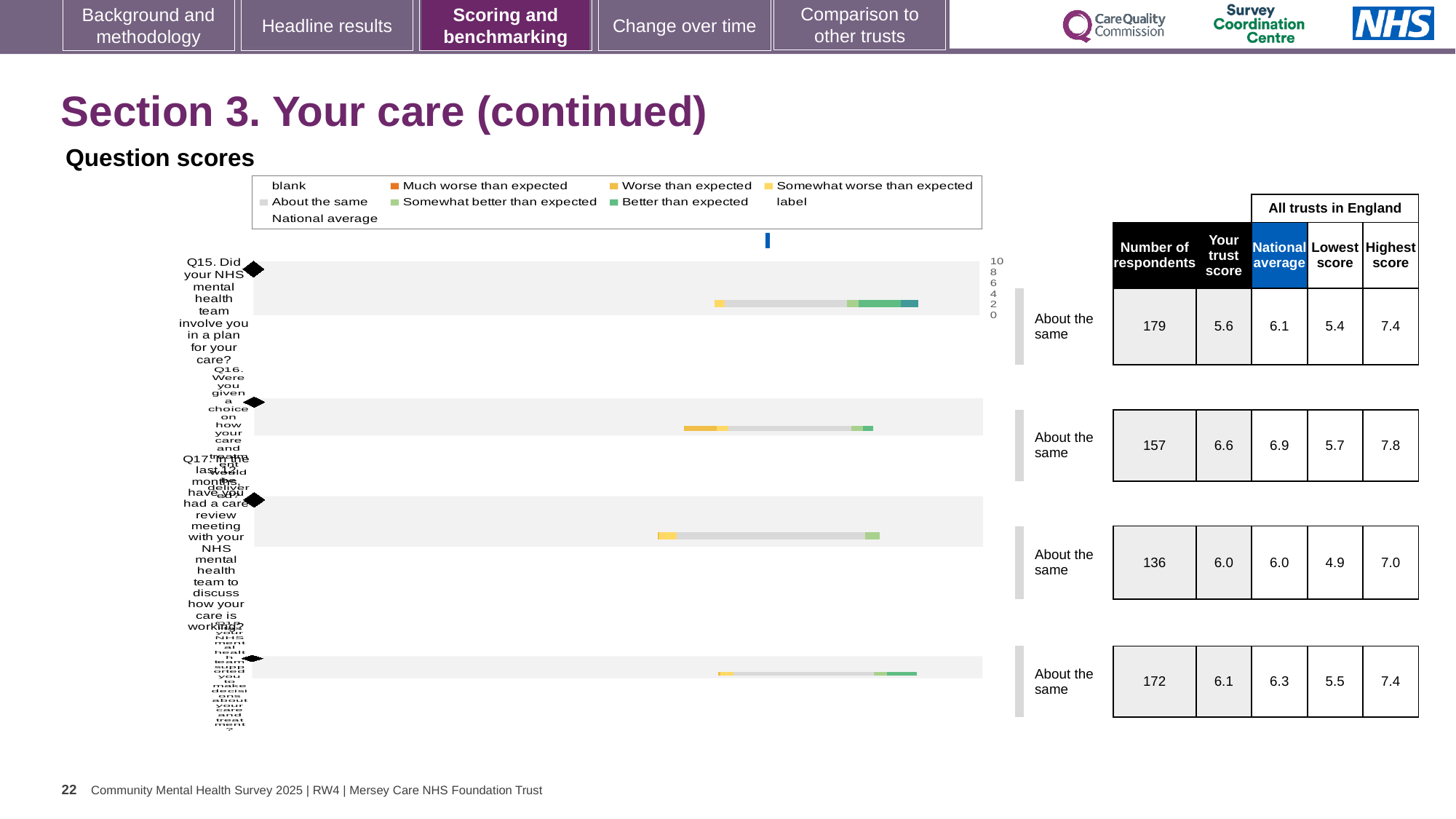
In the table beside the chart, what is the lowest score among all trusts in England for Q17? 4.9 In the table beside the chart, what is the number of respondents for Q15? 179 In the table beside the chart, what is the highest score among all trusts in England for Q16? 7.8 In the table beside the chart, what is the number of respondents for Q17? 136 Which legend entry is shown with a dark orange colour? Much worse than expected Which is larger for Q16 in the table beside the chart: the trust score or the national average? National average What kind of chart is shown under 'Question scores'? bar chart What is the title of the chart section on the slide? Question scores In the table beside the chart, what is the trust score for Q15? 5.6 In the table beside the chart, what is the national average for Q16? 6.9 How many question bars are plotted in the chart? 4 What is the difference between the national average and the trust score for Q15 in the table beside the chart? 0.5